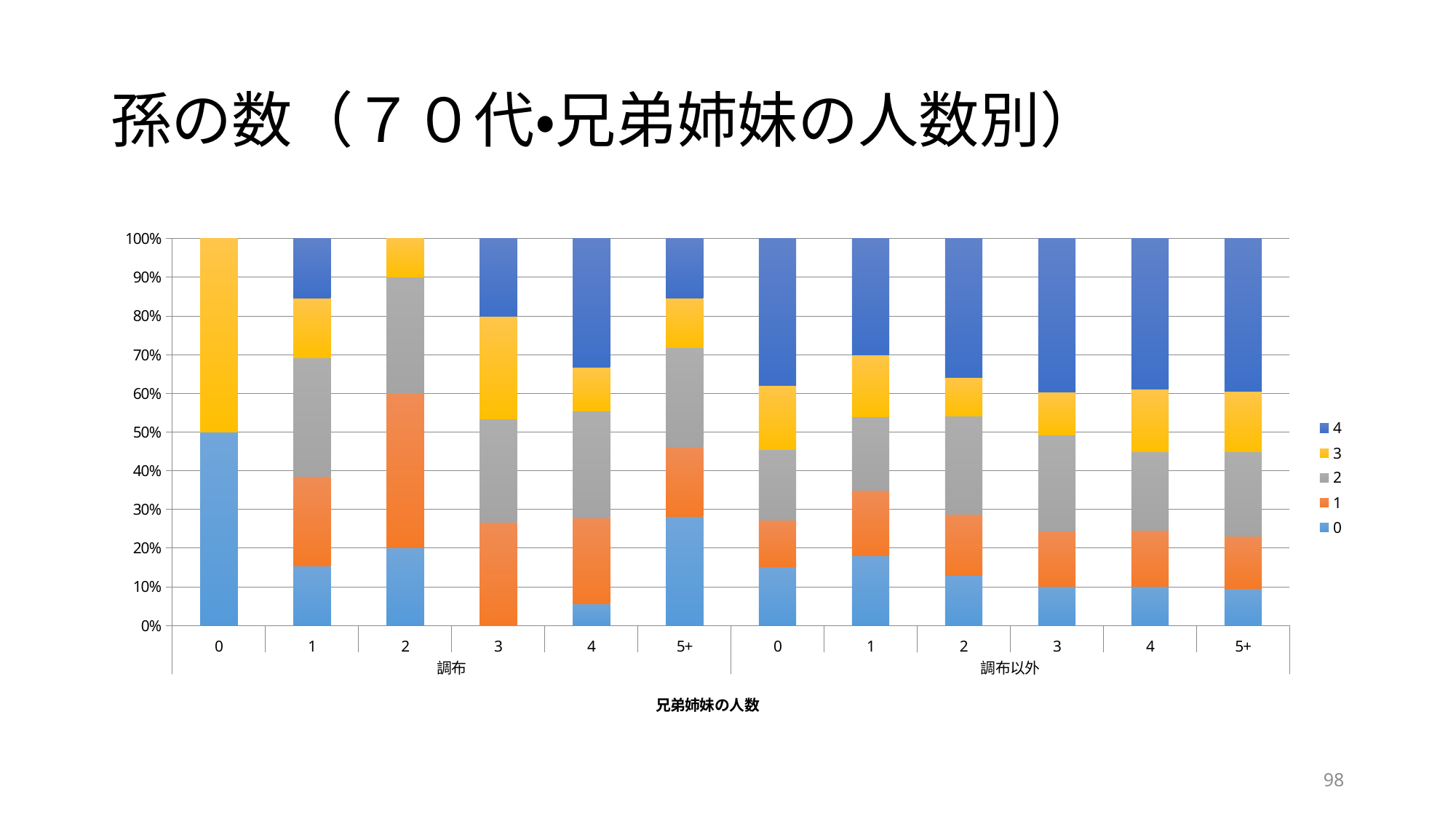
Which bar has the largest share of series 0? 調布 0 How many bars are plotted in the chart? 12 How many series does the legend list? 5 What is the title of the chart's horizontal axis? 兄弟姉妹の人数 Which bar has the larger share of series 4: 調布 1 or 調布以外 1? 調布以外 1 Which bar has the larger share of series 0: 調布 0 or 調布以外 0? 調布 0 What kind of chart is shown on the slide? Stacked bar chart What are the two groups into which the categories are divided along the x axis? 調布 and 調布以外 Is the share of series 0 in the 調布 4 bar greater or less than 10%? less Is the share of series 4 in the 調布以外 3 bar greater or less than 30%? greater What is the total of the stacked bar for 調布以外 2? 100% Is the share of series 0 in the 調布 0 bar greater or less than 40%? greater